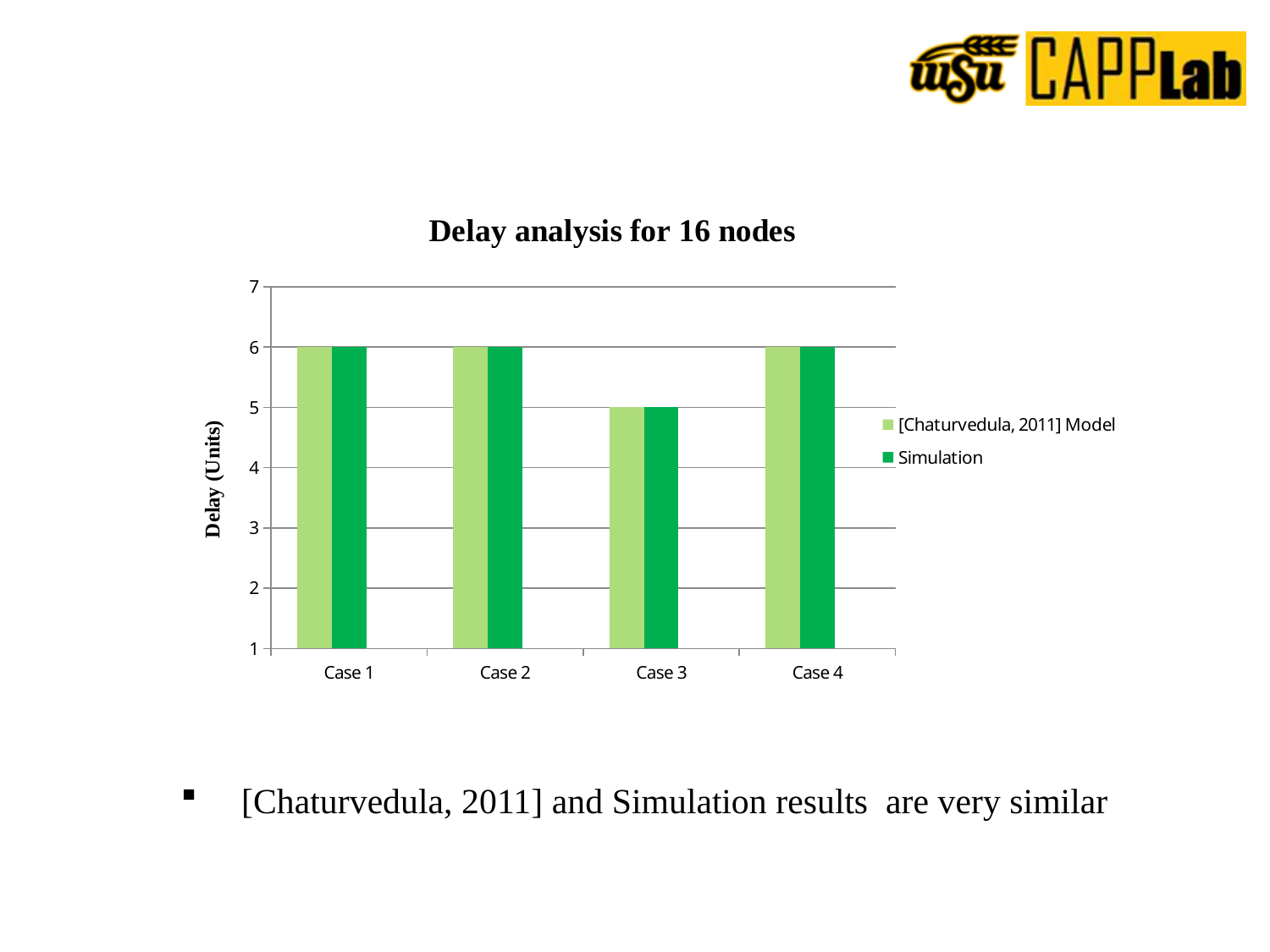
What is the Simulation value for Case 3? 5 How many series does the legend list? 2 Which is larger, the Simulation value for Case 2 or for Case 3? Case 2 What kind of chart is shown on the slide? bar chart Which case has the lowest Simulation value? Case 3 What is the title of the chart? Delay analysis for 16 nodes How many cases are shown on the x axis? 4 What is the label of the y axis? Delay (Units) What is the value for Case 1 in the [Chaturvedula, 2011] Model series? 6 What is the Simulation value for Case 4? 6 What is the difference between the [Chaturvedula, 2011] Model values for Case 1 and Case 3? 1 Is the Simulation value for Case 3 greater or less than 6? less